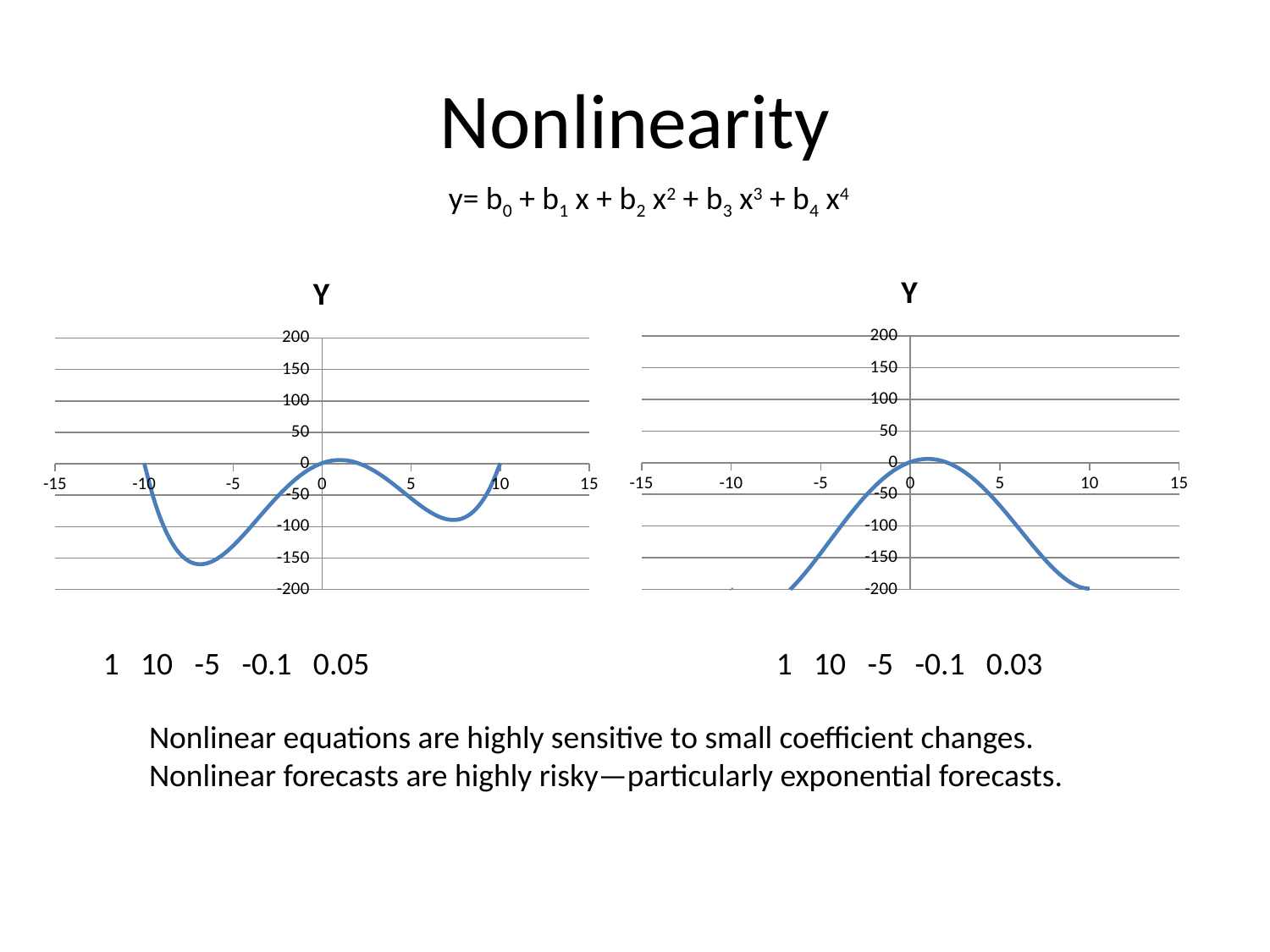
On the left chart, is the value of the curve at x = -7 greater or less than -100? less How many charts are shown on the slide? 2 On the left chart, which is larger: the value of the curve at x = 0 or at x = -7? x = 0 On the left chart, is the value of the curve at x = 0 greater or less than -50? greater On the right chart, is the value of the curve at x = 10 greater or less than -150? less On the right chart, do the values rise or fall as x increases from 1 to 10? fall What is the highest value shown on the y axis of the left chart? 200 Which chart's curve reaches a lower minimum value, the left chart or the right chart? the right chart What is the title of the right chart? Y What kind of chart is the left chart titled Y? line chart On the left chart, do the values rise or fall as x increases from -7 to 0? rise